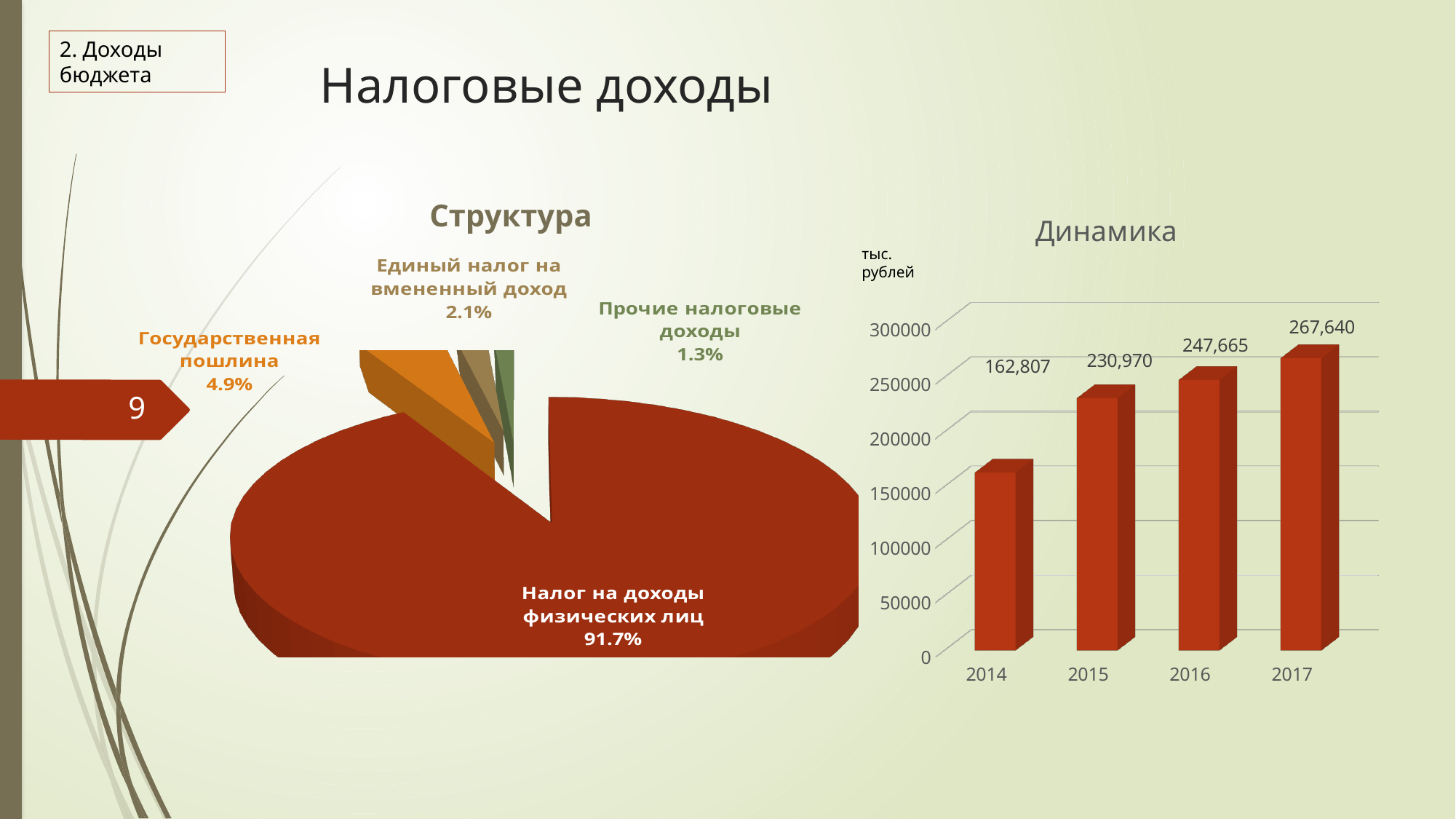
In the "Структура" pie chart, how many slices are there? 4 What kind of chart is the "Динамика" chart? bar chart In the "Динамика" chart, what is the value for 2015? 230,970 In the "Структура" pie chart, which category has the smallest share? Прочие налоговые доходы In the "Структура" pie chart, what share does "Налог на доходы физических лиц" have? 91.7% In the "Структура" pie chart, what share does "Государственная пошлина" have? 4.9% In the "Динамика" chart, what is the value for 2017? 267,640 In the "Динамика" chart, which year has the lowest value? 2014 In the "Динамика" chart, what is the difference between the 2017 and 2014 values? 104,833 In the "Динамика" chart, do the values rise or fall from 2014 to 2017? rise In the "Структура" pie chart, which is larger: "Единый налог на вмененный доход" or "Прочие налоговые доходы"? Единый налог на вмененный доход In the "Динамика" chart, what unit is shown on the vertical axis? тыс. рублей